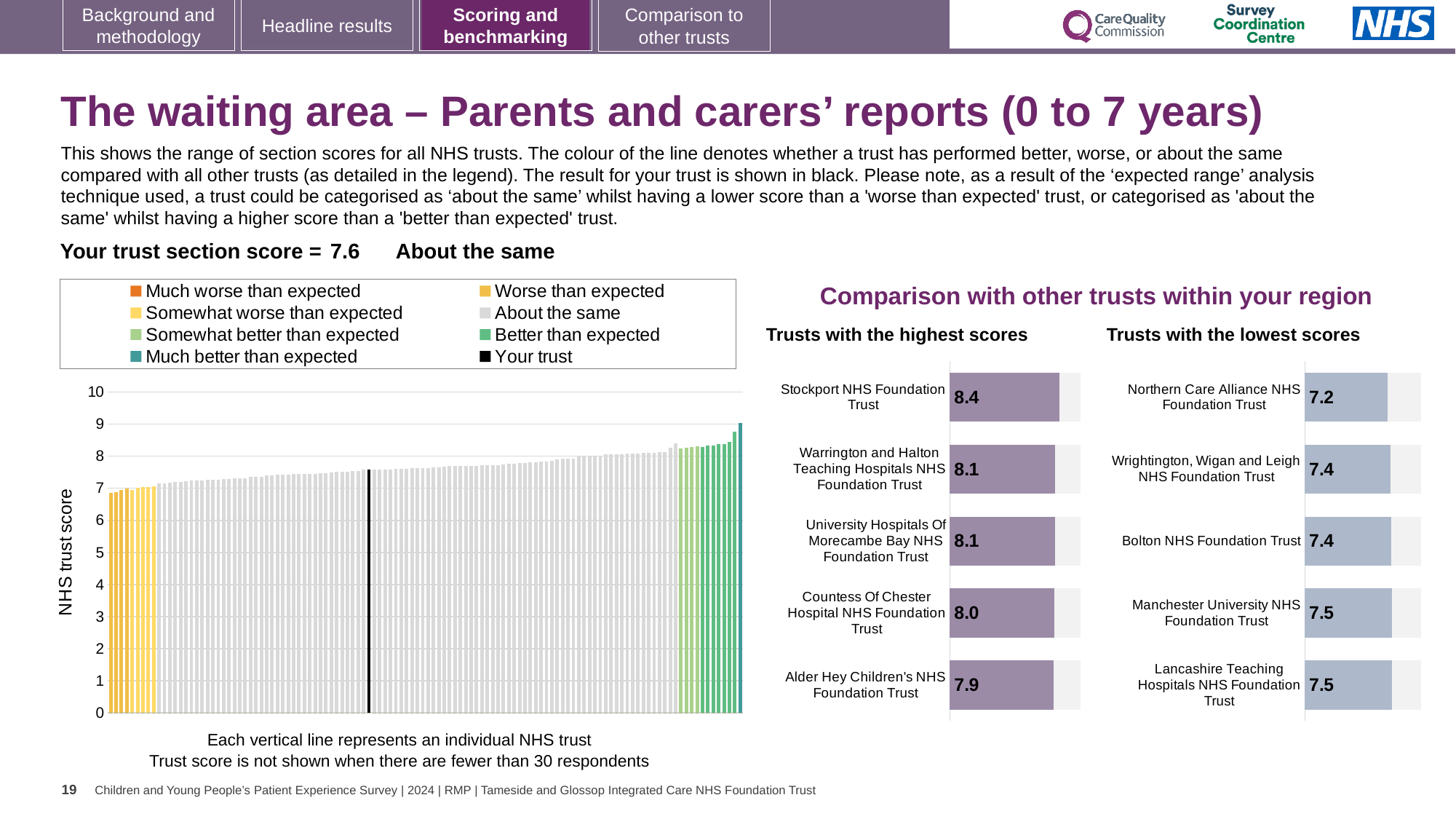
In the 'Trusts with the highest scores' chart, which trust has the highest score? Stockport NHS Foundation Trust In the 'Trusts with the lowest scores' chart, what is the score for Bolton NHS Foundation Trust? 7.4 What kind of chart is the main chart on the left showing NHS trust scores? Bar chart In the 'Trusts with the lowest scores' chart, which trust has the lowest score? Northern Care Alliance NHS Foundation Trust Which has the higher score: Countess Of Chester Hospital NHS Foundation Trust in the highest scores chart, or Bolton NHS Foundation Trust in the lowest scores chart? Countess Of Chester Hospital NHS Foundation Trust In the main 'NHS trust score' chart, do the bar values rise or fall from left to right? Rise In the 'Trusts with the lowest scores' chart, what is the score for Northern Care Alliance NHS Foundation Trust? 7.2 In the 'Trusts with the lowest scores' chart, how much higher is Lancashire Teaching Hospitals NHS Foundation Trust's score than Northern Care Alliance NHS Foundation Trust's? 0.3 In the 'Trusts with the highest scores' chart, what is the difference between the scores of Stockport NHS Foundation Trust and Alder Hey Children's NHS Foundation Trust? 0.5 How many entries does the legend of the main 'NHS trust score' chart list? 8 How many trusts are listed in the 'Trusts with the highest scores' chart? 5 In the 'Trusts with the highest scores' chart, what is the score for Stockport NHS Foundation Trust? 8.4